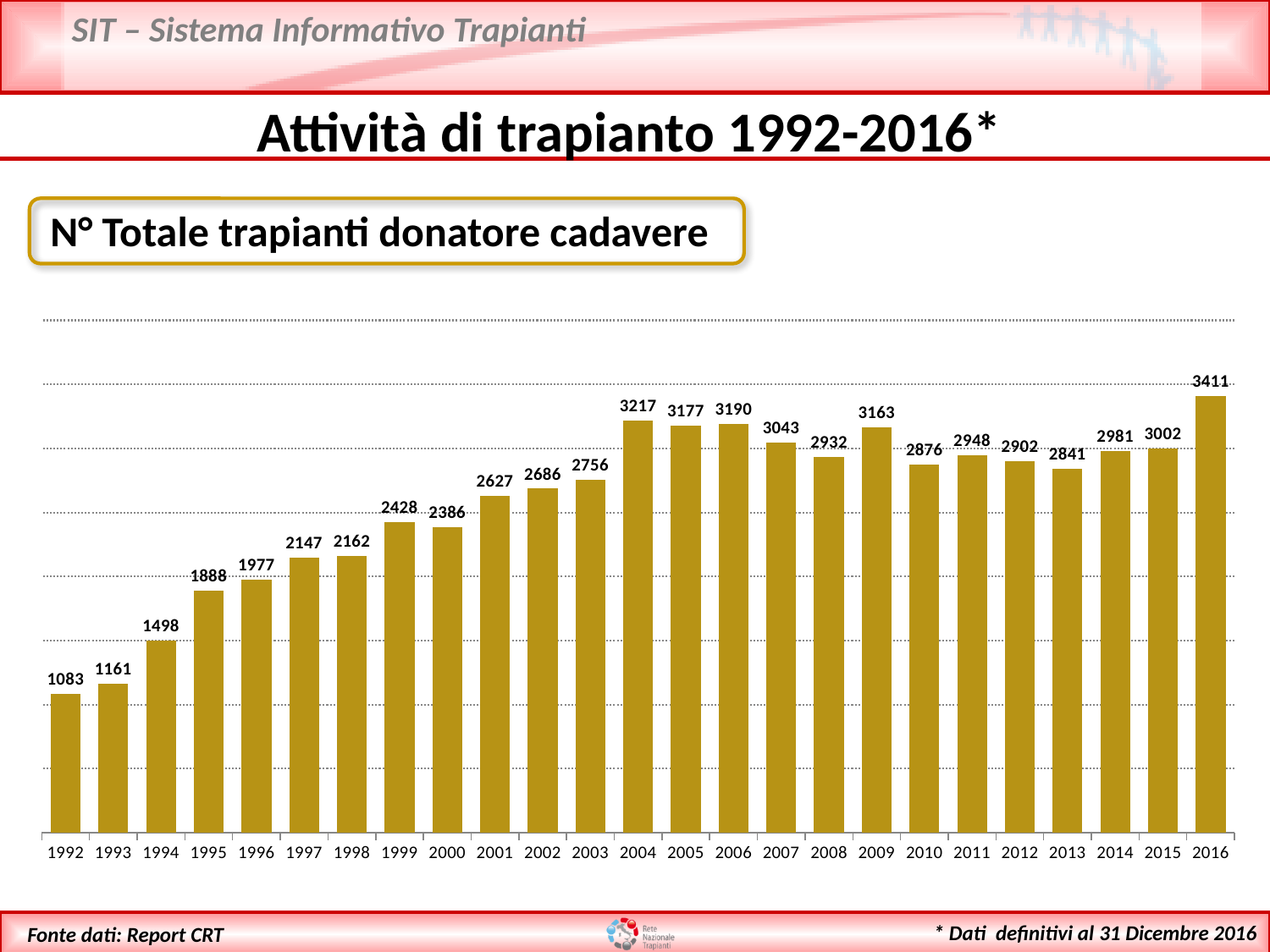
What is the value for 1992? 1083 How many years are shown on the x axis? 25 What is the title shown in the box above the chart? N° Totale trapianti donatore cadavere Do the values rise or fall from 1992 to 1999? rise Which year has the highest value? 2016 What kind of chart is this? bar chart Which is larger, the value for 1999 or the value for 2000? 1999 What is the value for 2004? 3217 What is the value for 2013? 2841 What is the difference between the values for 2004 and 2003? 461 Which year has the lowest value? 1992 What is the difference between the values for 2016 and 2015? 409